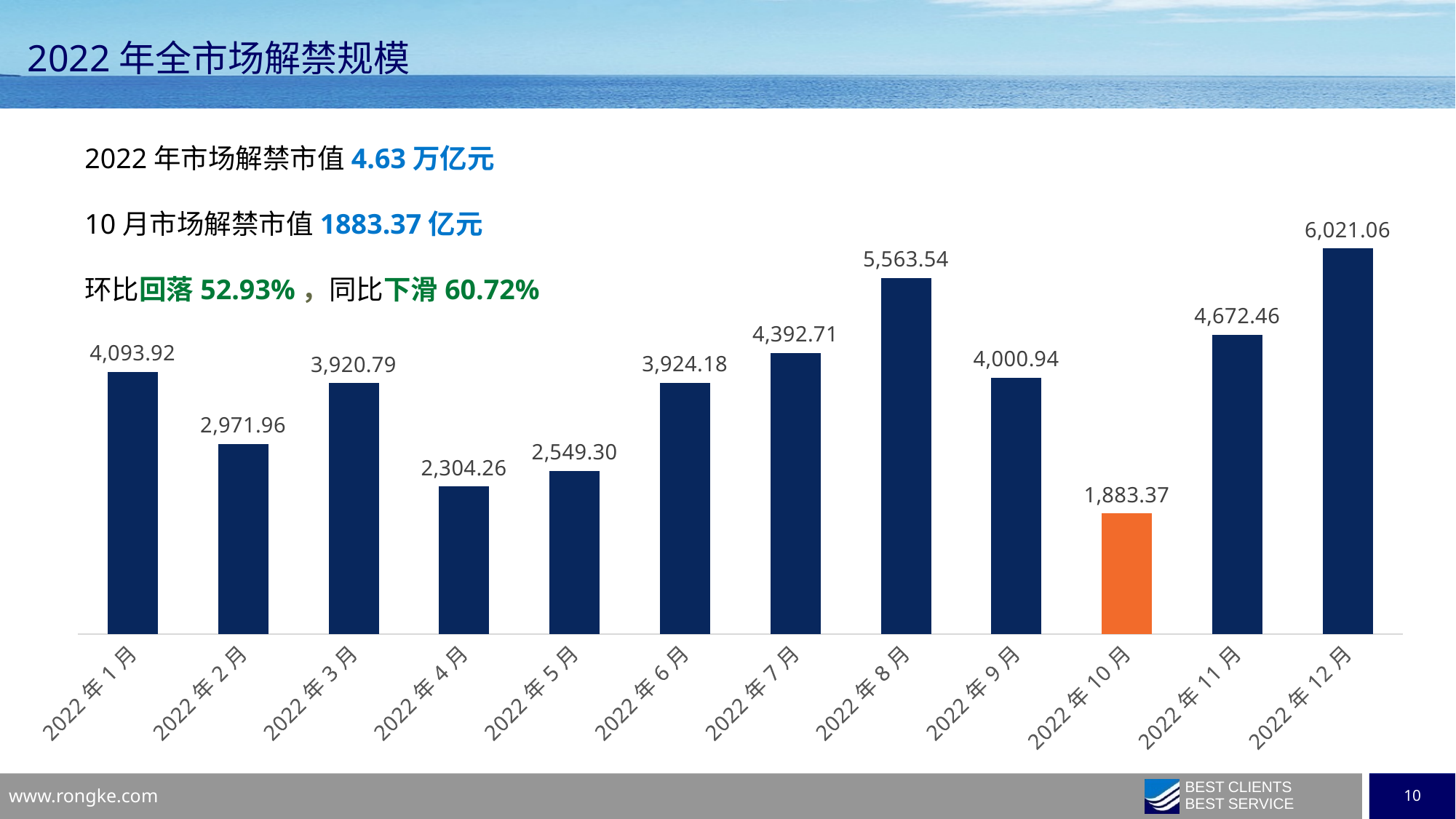
What is the difference between the values for 2022年8月 and 2022年7月? 1,170.83 What is the value for 2022年10月? 1,883.37 Do the values rise or fall from 2022年4月 to 2022年8月? Rise What is the value for 2022年8月? 5,563.54 What is the value for 2022年4月? 2,304.26 Which is larger, the value for 2022年11月 or 2022年7月? 2022年11月 What kind of chart is shown on the slide? Bar chart How many months are shown in the chart? 12 Which month has the lowest value? 2022年10月 Which month has the highest value? 2022年12月 Which month's bar is coloured orange? 2022年10月 What is the difference between the values for 2022年12月 and 2022年10月? 4,137.69